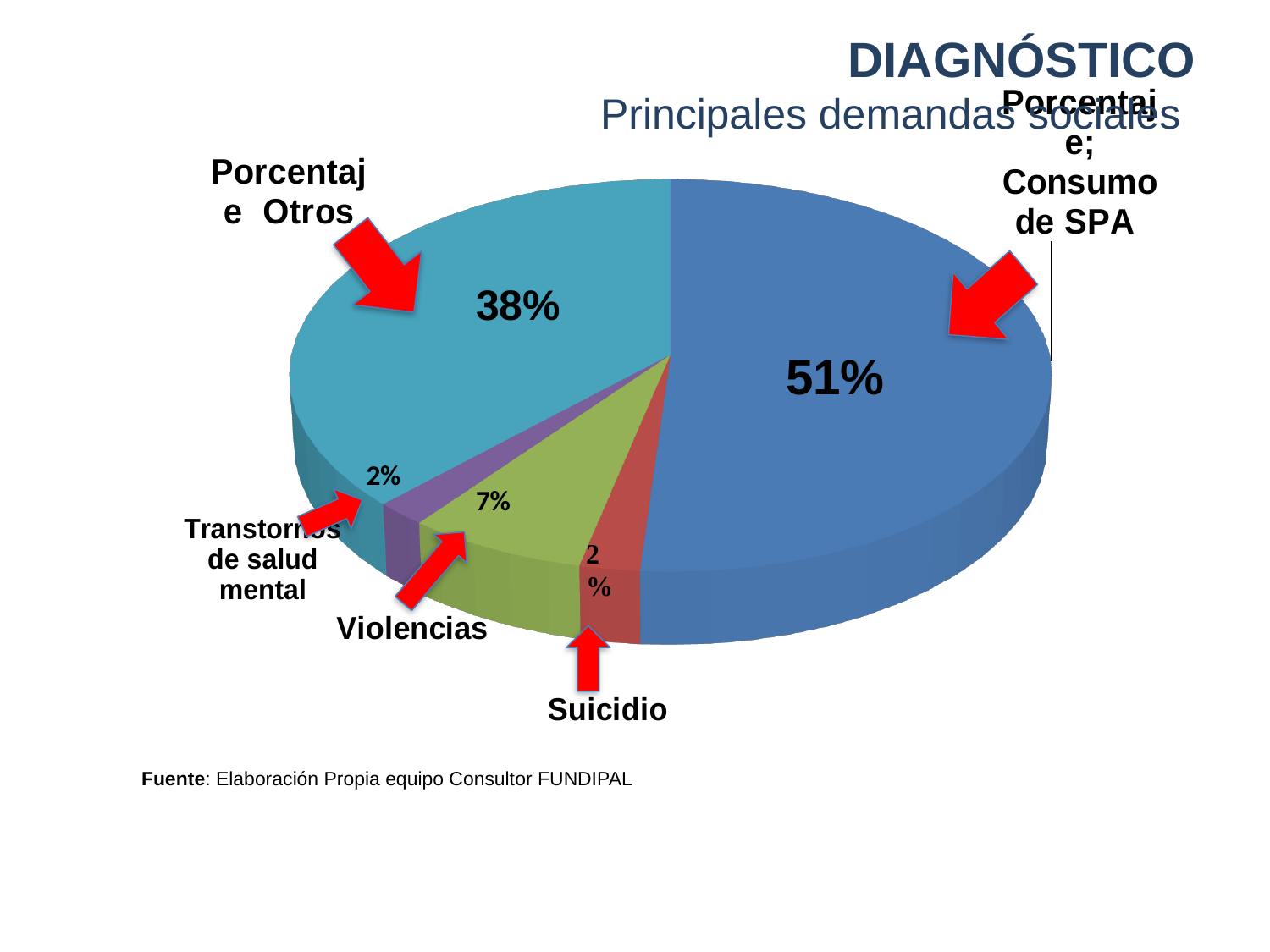
What percentage of the pie corresponds to Violencias? 7% What percentage of the pie corresponds to Consumo de SPA? 51% Which is larger, the share for Violencias or the share for Suicidio? Violencias What percentage of the pie corresponds to Otros? 38% What is the difference in percentage points between Consumo de SPA and Otros? 13 What is the subtitle of the chart on the slide? Principales demandas sociales What percentage of the pie corresponds to Suicidio? 2% What is the difference in percentage points between Otros and Violencias? 31 What kind of chart is shown on the slide? Pie chart How many slices does the pie chart have? 5 Which category has the largest share of the pie? Consumo de SPA What percentage of the pie corresponds to Transtornos de salud mental? 2%